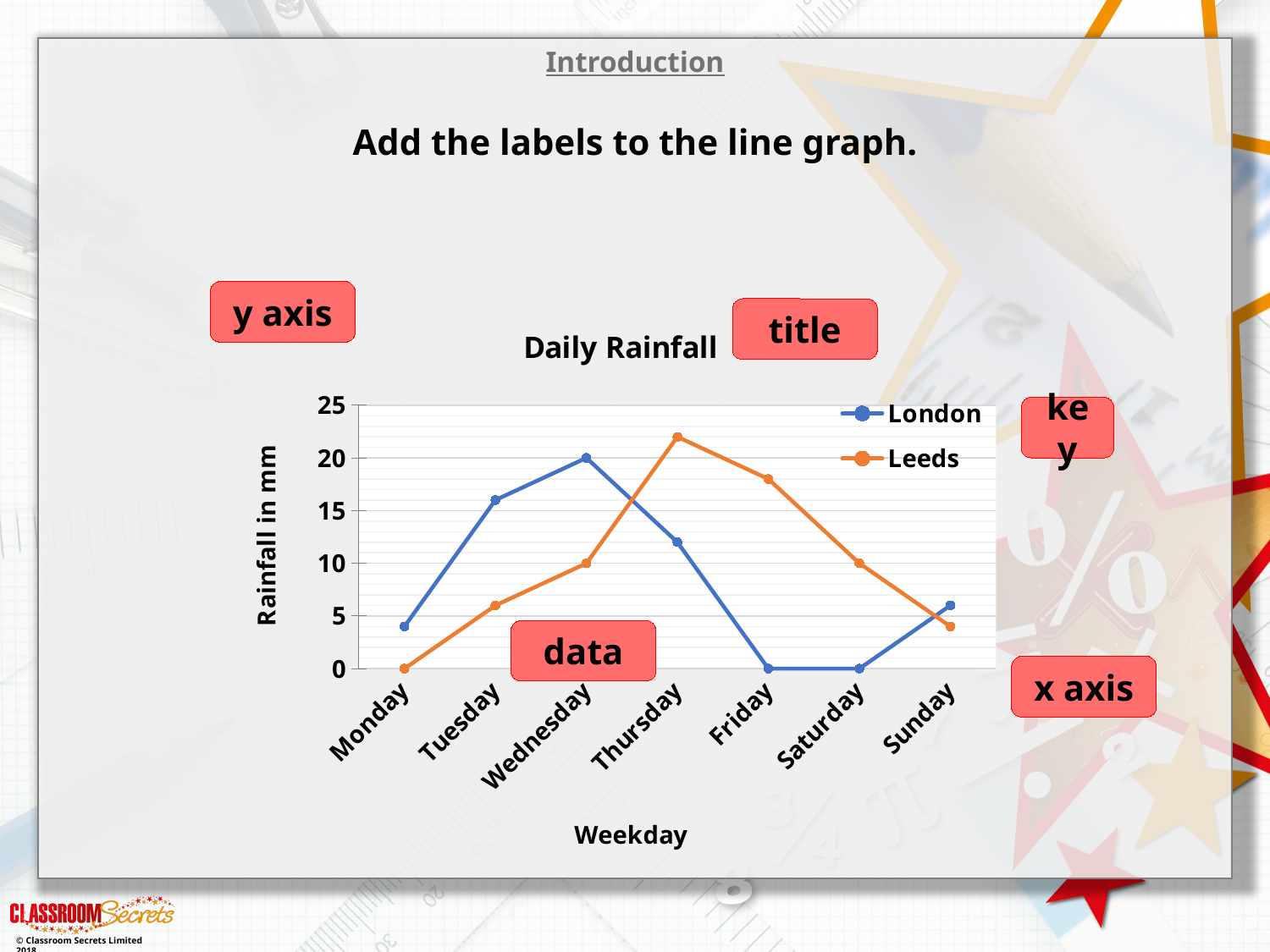
On Thursday, which has more rainfall, London or Leeds? Leeds How many series does the legend list? 2 On which day is the rainfall for Leeds highest? Thursday Is the rainfall for Leeds on Friday greater or less than 15? greater How many weekdays are plotted along the x axis? 7 What is the difference in rainfall in mm between London and Leeds on Wednesday? 10 What is the title of the chart? Daily Rainfall On which day is the rainfall for Leeds lowest? Monday What is the rainfall in mm for Leeds on Saturday? 10 What type of chart is shown on the slide? line chart On which day is the rainfall for London highest? Wednesday What is the rainfall in mm for London on Wednesday? 20